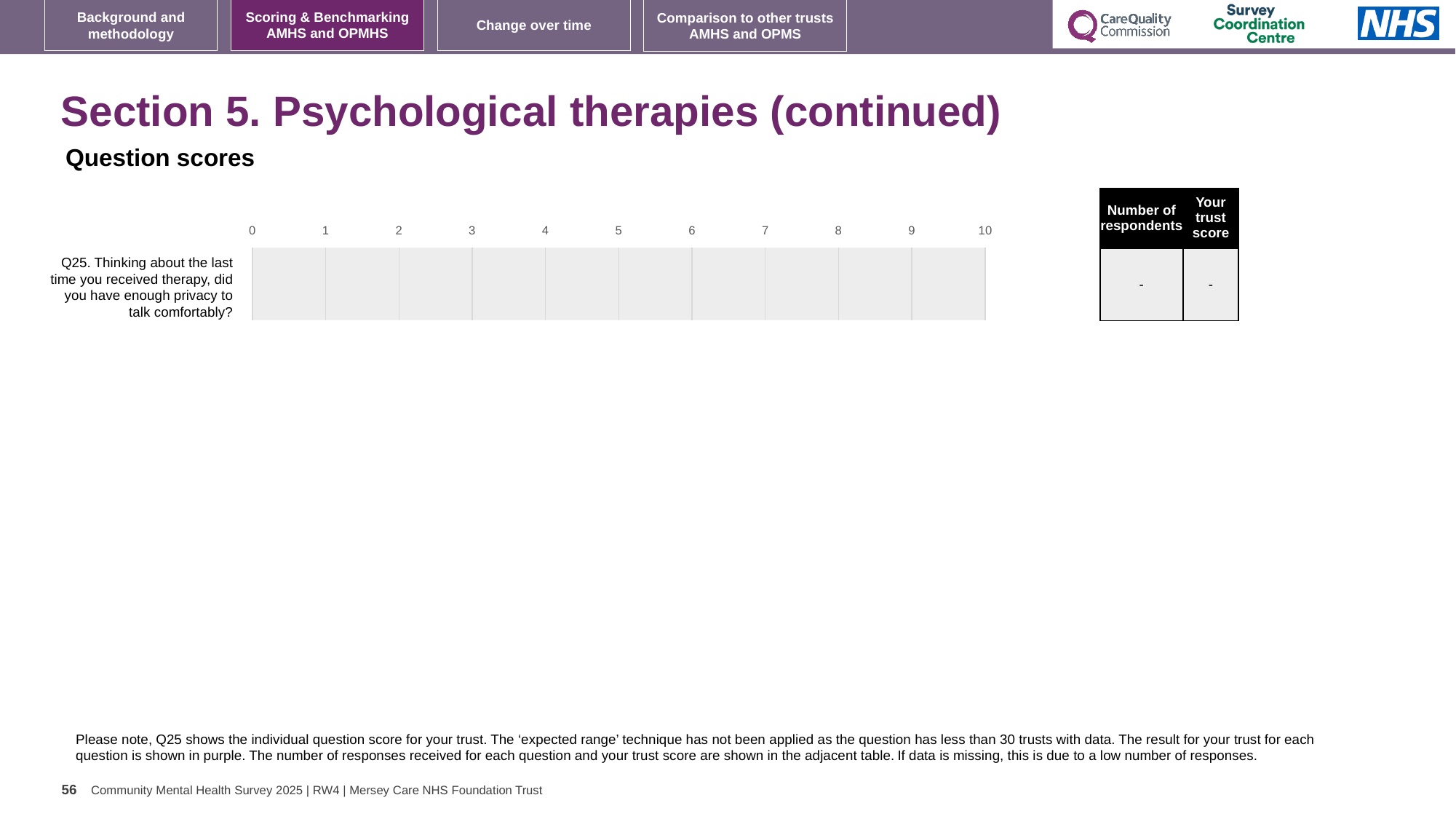
Which question number is shown on the chart? Q25 How many questions (categories) are shown on the chart? 1 What is shown in the 'Your trust score' column for Q25? - What is the lowest value shown on the chart's axis? 0 What kind of chart is used to show the question scores? bar chart What is shown in the 'Number of respondents' column for Q25? - Is a bar plotted for Q25 on the chart? No What is the highest value shown on the chart's axis? 10